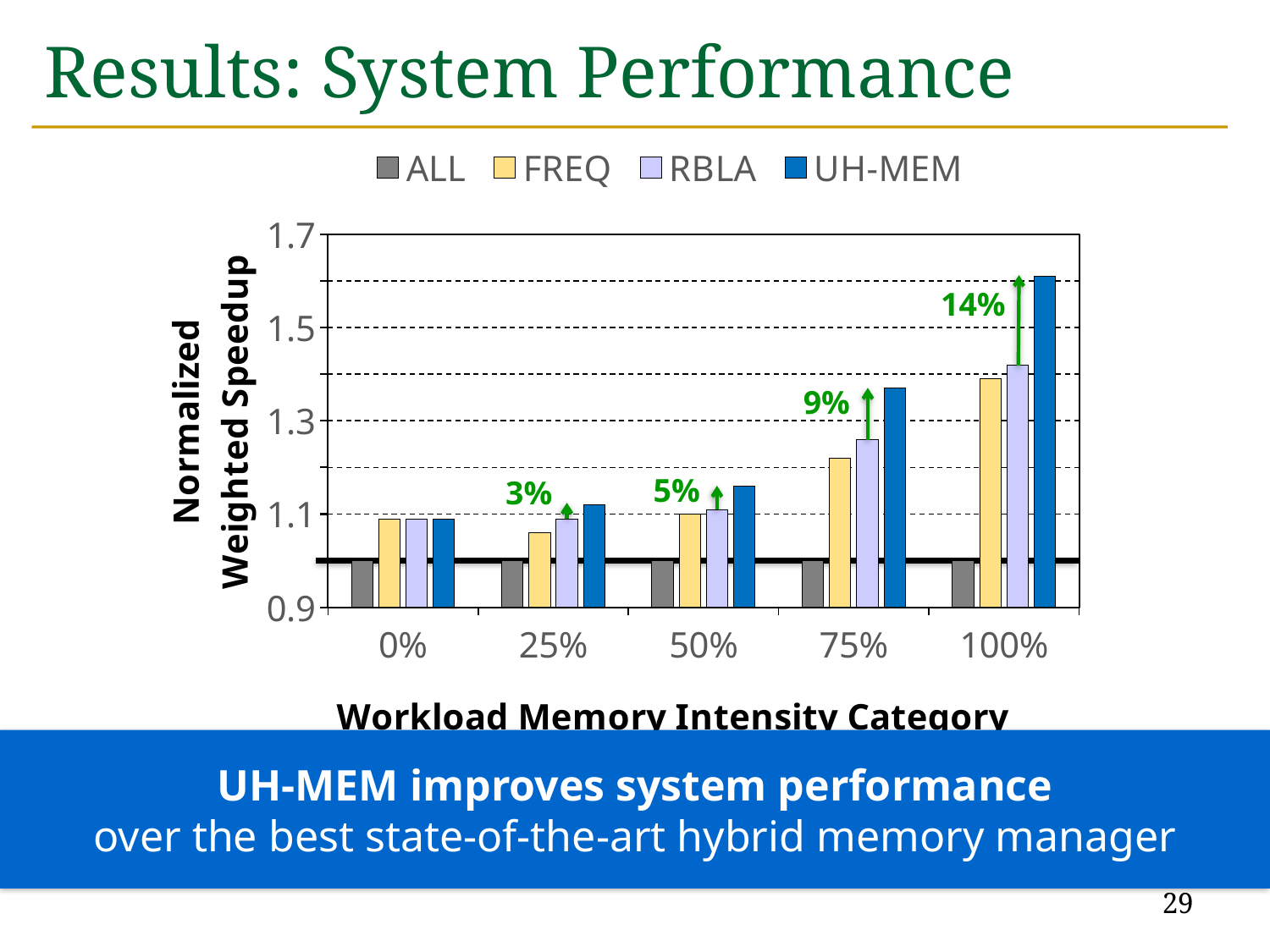
Is the value for UH-MEM in the 100% category greater or less than 1.5? greater Do the UH-MEM values rise or fall as the workload memory intensity category increases from 0% to 100%? rise In which workload memory intensity category is the UH-MEM bar highest? 100% Is the value for RBLA in the 100% category greater or less than 1.5? less Is the value for UH-MEM in the 75% category greater or less than 1.3? greater What improvement percentage is annotated above the 100% category? 14% What kind of chart is shown on the slide? bar chart How many workload memory intensity categories are shown on the x axis? 5 How many series does the legend list? 4 Which series has the lowest bar in the 75% category? ALL Which series has the highest bar in the 100% category? UH-MEM